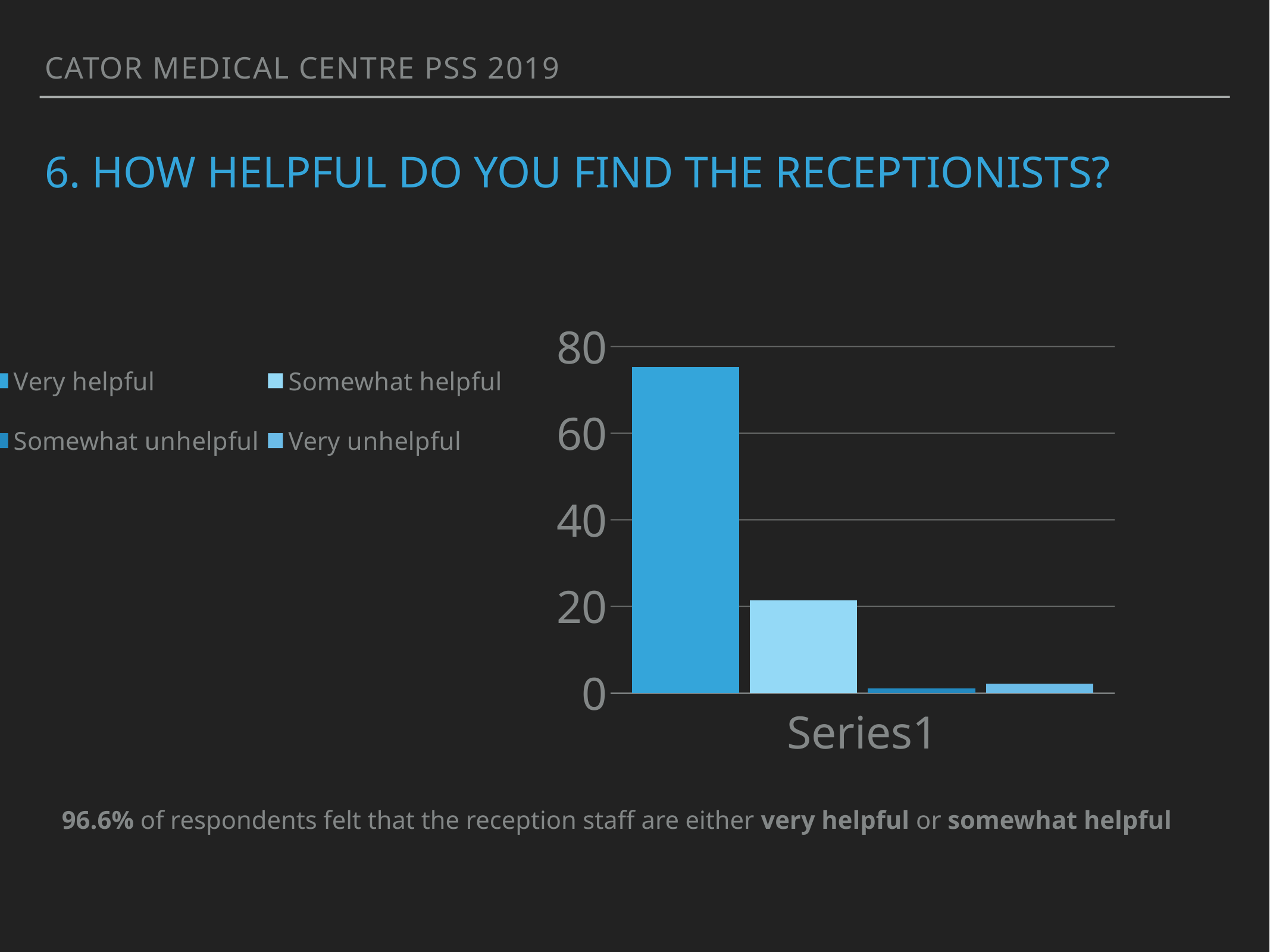
Is the value for Somewhat helpful greater or less than 40? less How many categories are shown on the x axis? 1 Is the value for Very helpful greater or less than 60? greater Which series has the highest bar? Very helpful Which is larger, the value for Very helpful or the value for Somewhat helpful? Very helpful Is the value for Somewhat unhelpful greater or less than 20? less How many series does the legend list? 4 What kind of chart is shown on the slide? bar chart What is the label shown on the x axis? Series1 What is the highest value shown on the y axis? 80